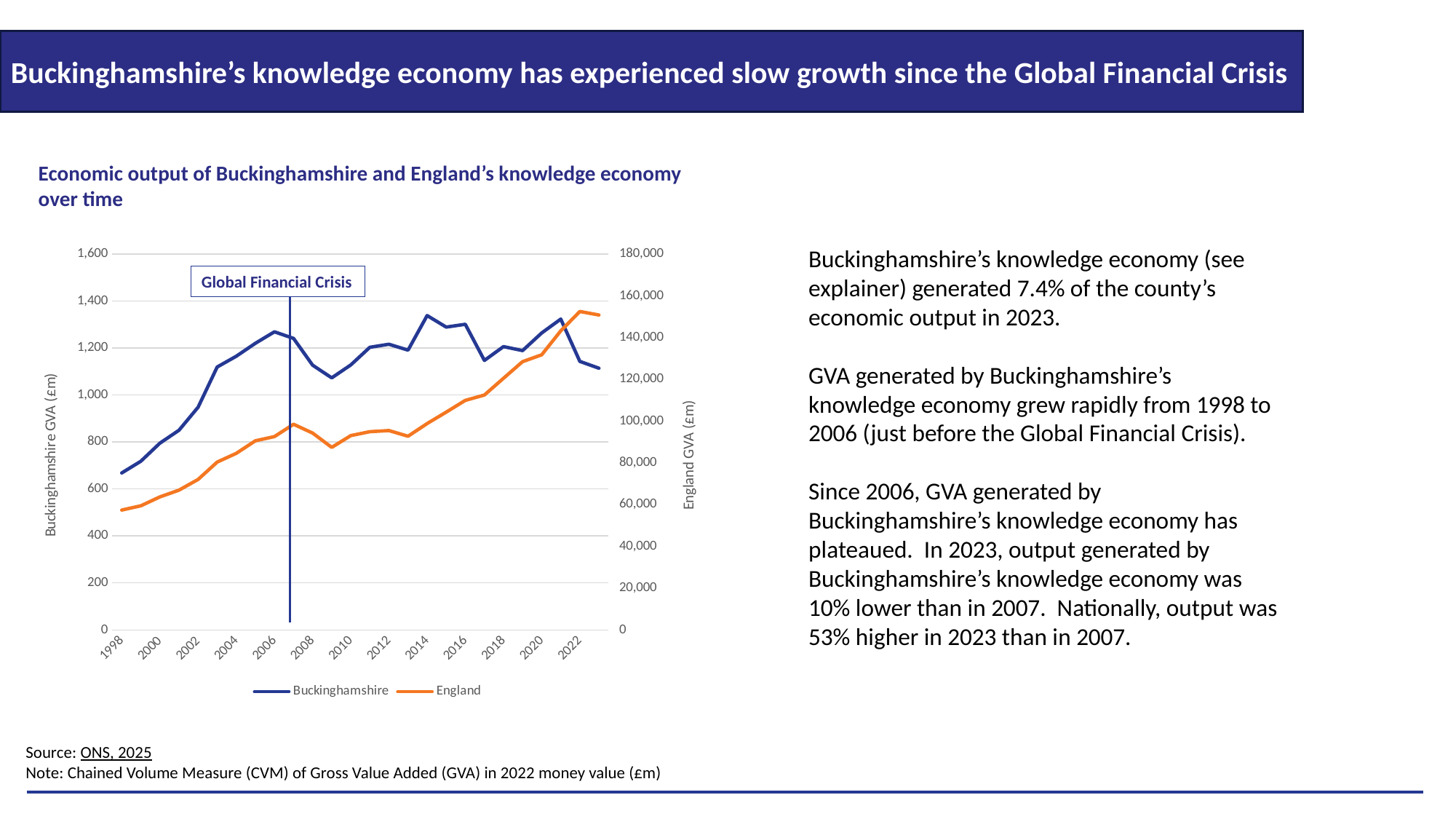
Which two series are listed in the chart's legend? Buckinghamshire and England What kind of chart is shown on the slide? Line chart How many series does the chart's legend list? 2 Is the England GVA value for 1998 greater or less than 60,000? less Does the England GVA line generally rise or fall from 1998 to 2023? Rise In which year is the Buckinghamshire GVA line at its lowest? 1998 What event is marked by the vertical line annotation on the chart? Global Financial Crisis Which is larger for Buckinghamshire GVA: the value in 2006 or the value in 2009? 2006 Is the Buckinghamshire GVA value for 2006 greater or less than 1,200? greater Is the Buckinghamshire GVA value for 2023 greater or less than 1,200? less